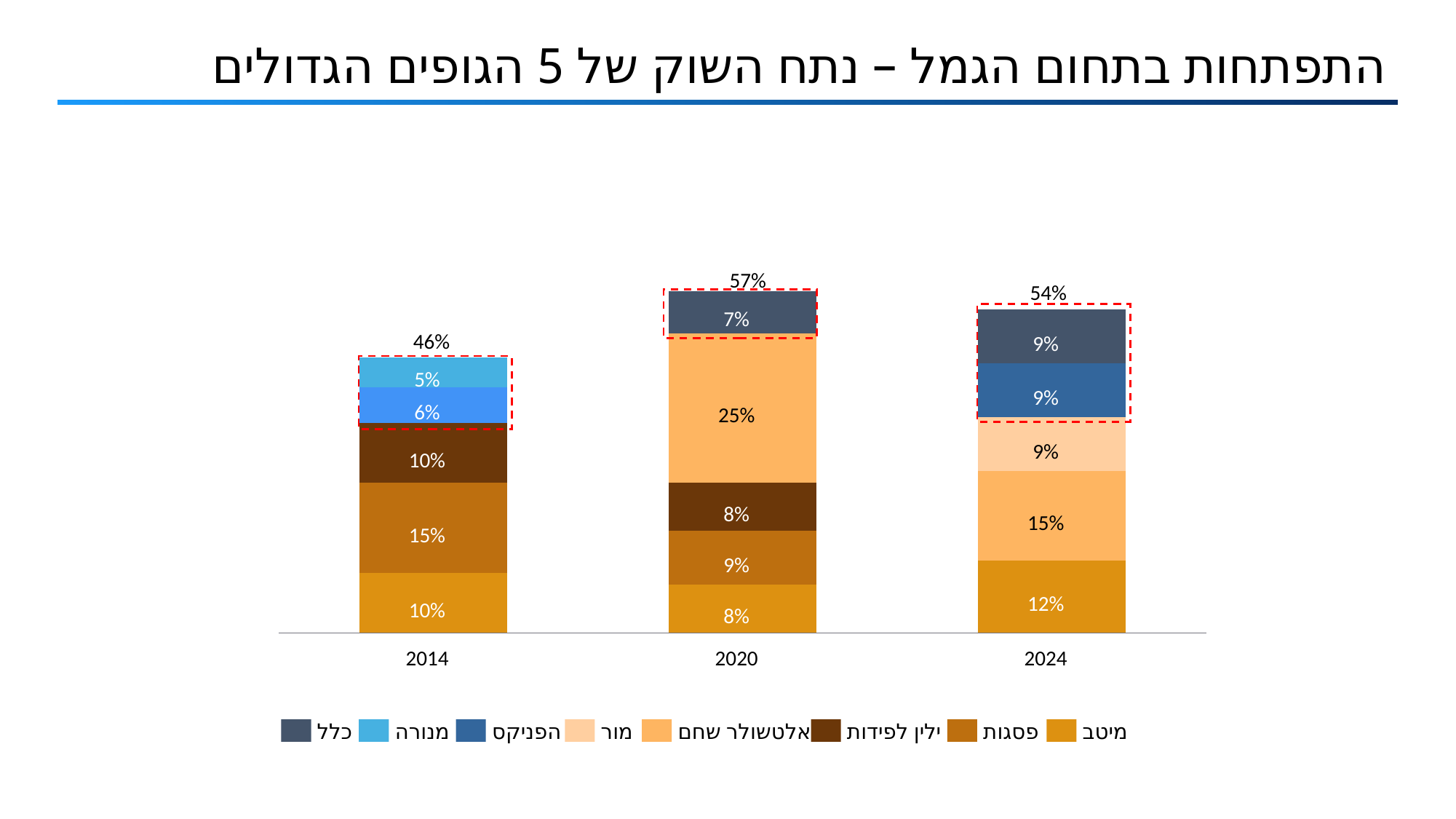
How many years (categories) are shown on the x axis? 3 Which year has the lowest total market share of the 5 largest bodies? 2014 Which is larger: the value for מיטב in 2014 or the value for מיטב in 2024? 2024 What is the total market share shown above the 2014 bar? 46% What is the value for מיטב in 2024? 12% How many series does the legend list? 8 What type of chart is shown on the slide? Stacked bar chart What is the value for אלטשולר שחם in 2020? 25% What is the total market share shown above the 2020 bar? 57% What is the difference between the total for 2020 and the total for 2024? 3% Which year has the highest total market share of the 5 largest bodies? 2020 What is the value for פסגות in 2014? 15%